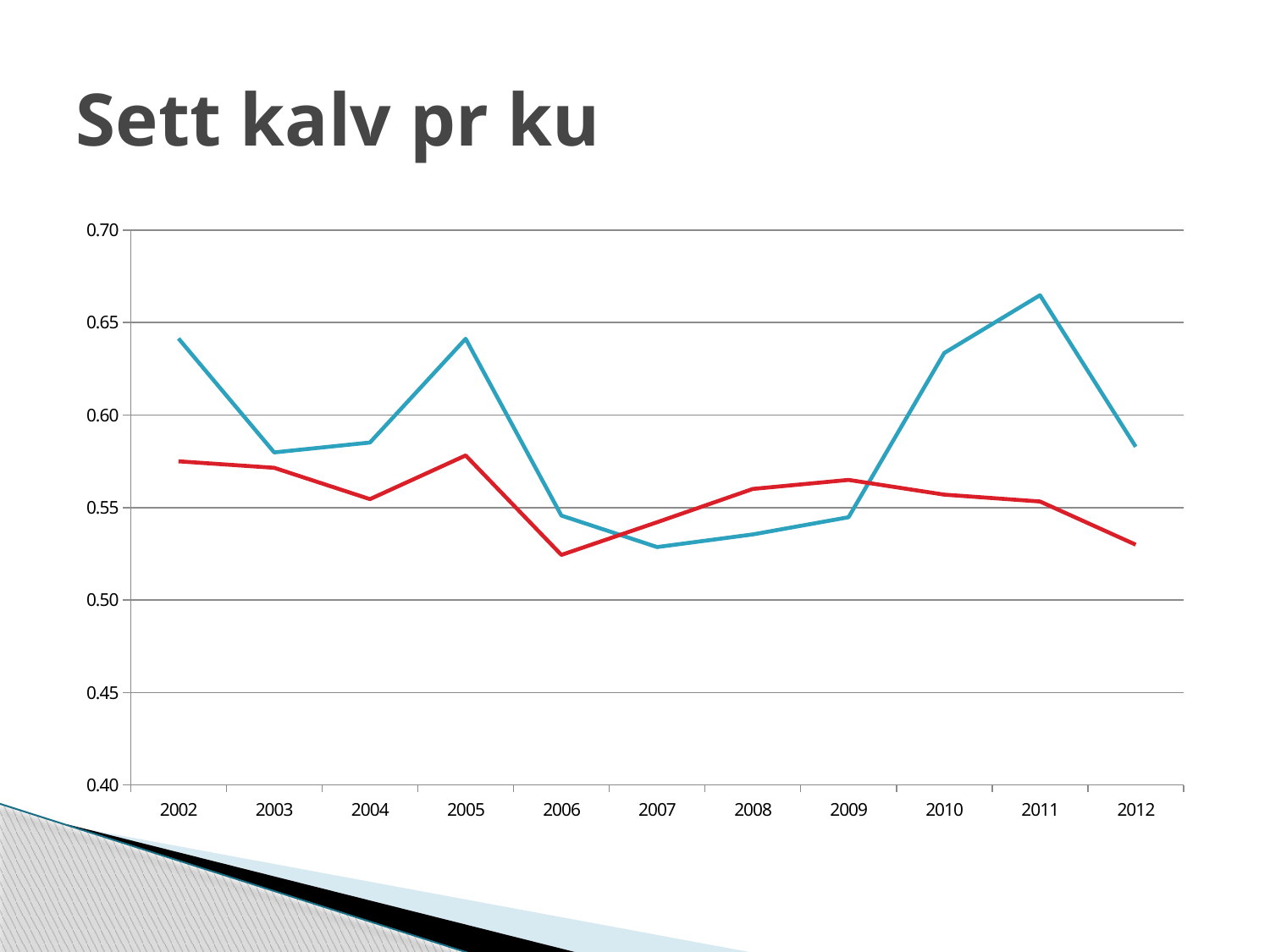
Is the value of the blue line in 2007 greater or less than 0.55? less Does the blue line rise or fall from 2009 to 2011? rise In 2007, which line has the higher value, the blue line or the red line? the red line What is the title of the chart? Sett kalv pr ku Is the value of the blue line in 2002 greater or less than 0.60? greater What kind of chart is shown on the slide? line chart Is the value of the blue line in 2011 greater or less than 0.65? greater In 2002, which line has the higher value, the blue line or the red line? the blue line How many years are shown on the x axis of the chart? 11 In which year does the blue line reach its highest value? 2011 How many lines are plotted on the chart? 2